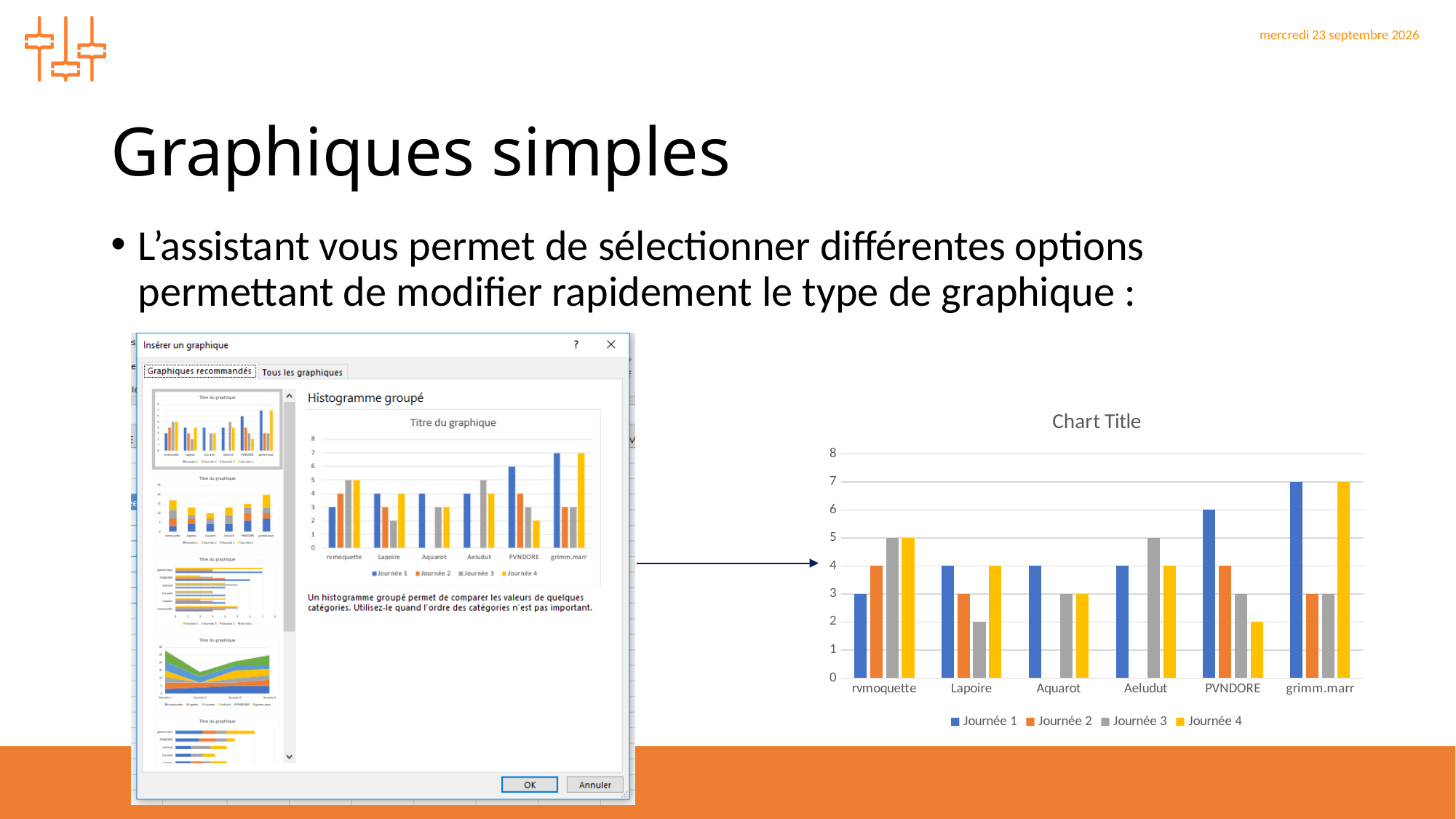
On the chart titled "Chart Title" on the right, which category has the lowest Journée 4 value? PVNDORE On the chart titled "Chart Title" on the right, what is the value of Journée 1 for PVNDORE? 6 On the chart titled "Chart Title" on the right, what are the legend entries? Journée 1, Journée 2, Journée 3, Journée 4 On the chart titled "Chart Title" on the right, how many categories are shown on the x axis? 6 On the chart titled "Chart Title" on the right, which category has the highest Journée 1 value? grimm.marr On the chart titled "Chart Title" on the right, which is larger: Journée 3 for rvmoquette or Journée 3 for Lapoire? Journée 3 for rvmoquette On the chart titled "Chart Title" on the right, what is the value of Journée 1 for grimm.marr? 7 On the chart titled "Chart Title" on the right, what is the value of Journée 3 for Lapoire? 2 On the chart titled "Chart Title" on the right, how many series does the legend list? 4 On the chart titled "Chart Title" on the right, what is the difference between the Journée 1 values for grimm.marr and rvmoquette? 4 On the chart titled "Chart Title" on the right, what is the value of Journée 4 for PVNDORE? 2 On the chart titled "Chart Title" on the right, what kind of chart is shown? bar chart